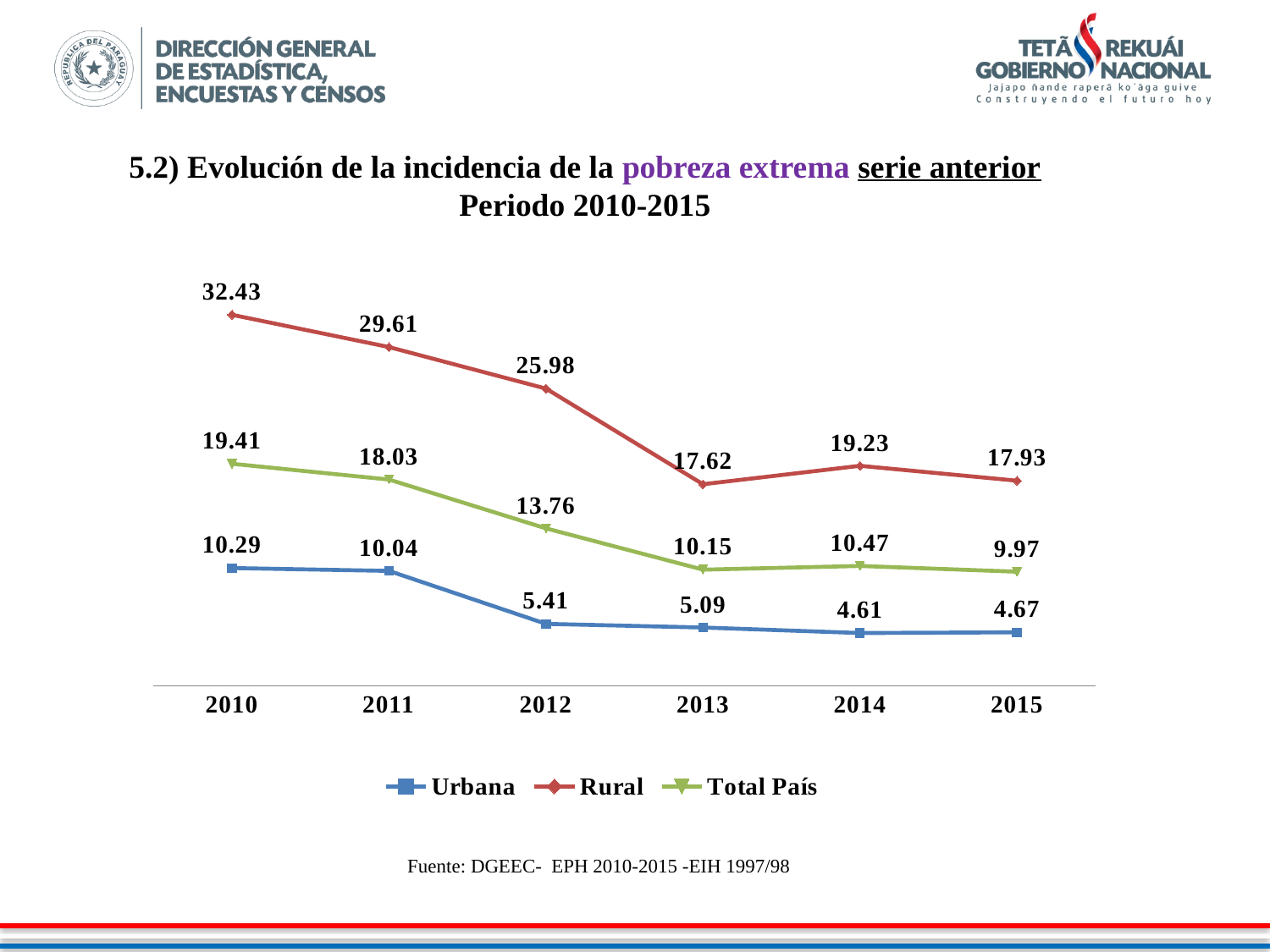
What kind of chart is shown? line chart In which year is the Urbana series highest? 2010 How many years are shown on the x axis? 6 How many series does the legend list? 3 What is the difference between the Rural values in 2010 and 2015? 14.50 What is the Urbana value in 2014? 4.61 What is the Rural value in 2010? 32.43 In which year is the Rural series lowest? 2013 Does the Total País series generally rise or fall from 2010 to 2015? fall What is the difference between the Total País and Urbana values in 2013? 5.06 What is the Total País value in 2012? 13.76 Which is larger, the Rural value in 2014 or the Rural value in 2015? 2014